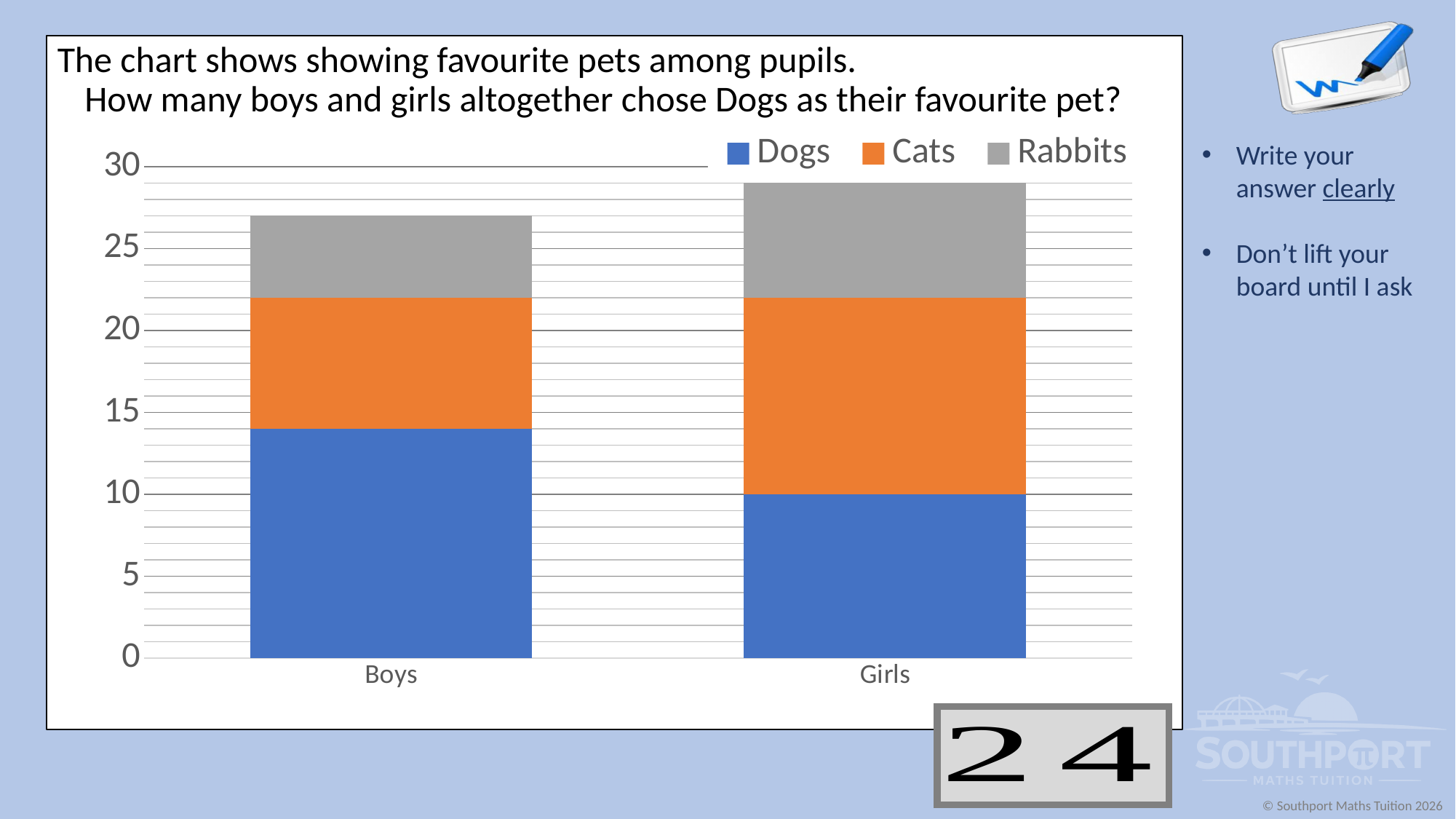
What are the series listed in the chart's legend? Dogs, Cats, Rabbits How many categories are shown on the x axis of the chart? 2 What colour represents Dogs in the chart? Blue Which group has more pupils who chose Cats, Boys or Girls? Girls How many girls chose Dogs as their favourite pet? 10 Is the total height of the Girls bar greater or less than 25? greater How many series does the chart's legend list? 3 Is the number of boys who chose Dogs greater or less than 15? less Is the number of boys who chose Dogs greater or less than 10? greater Which group has more pupils who chose Dogs, Boys or Girls? Boys What kind of chart is shown on the slide? Stacked bar chart